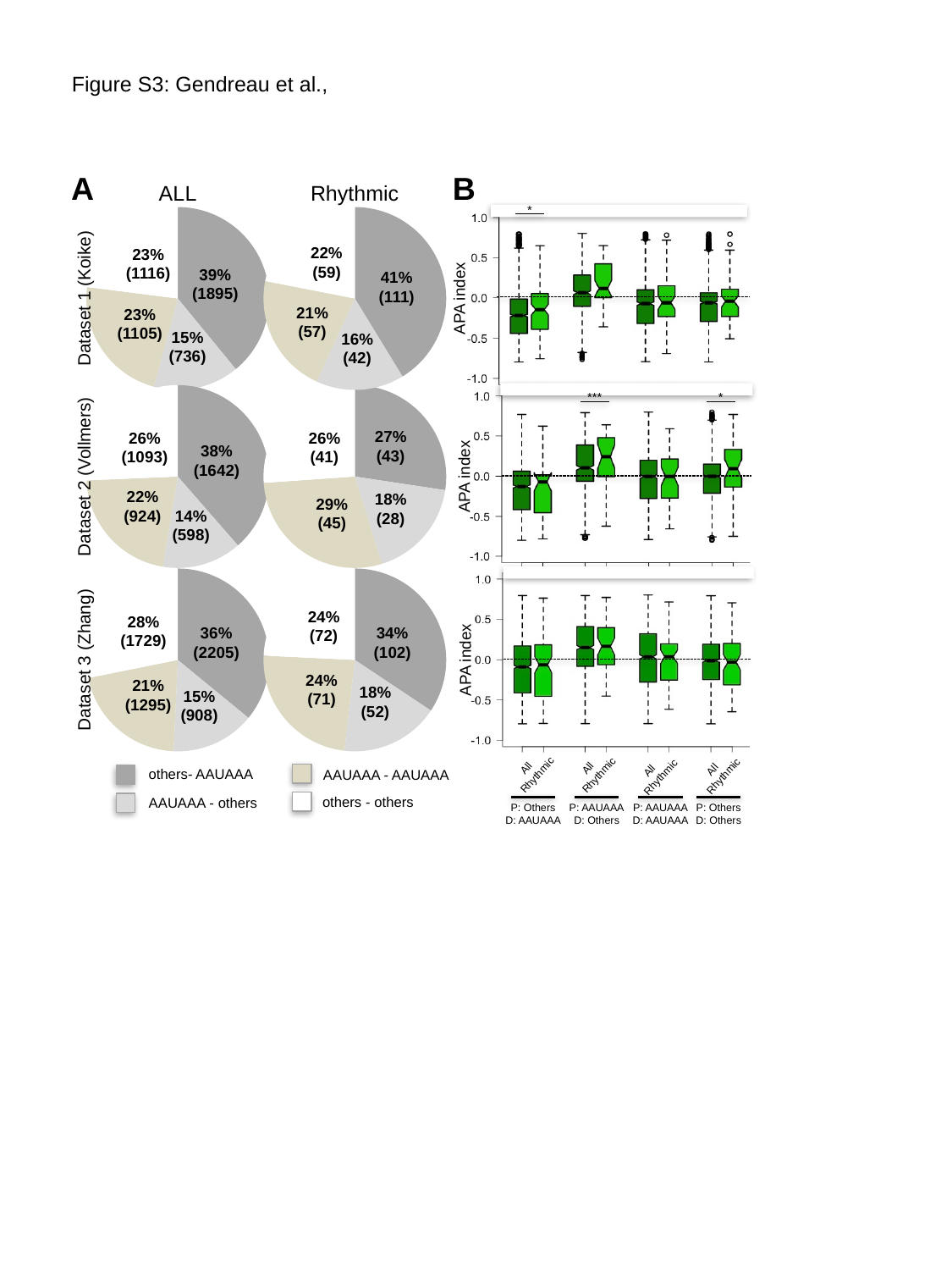
What type of chart is used in panel B? Box plot How many slices does each pie chart in panel A have? 4 In the Dataset 2 (Vollmers) ALL pie chart, which slice has the smallest percentage? AAUAAA - others (14%) In the Dataset 1 (Koike) Rhythmic pie chart, what count is shown in parentheses for the 41% slice? 111 How many pie charts are shown in panel A? 6 In the Dataset 1 (Koike) ALL pie chart, which is larger: the 39% (1895) slice or the 15% (736) slice? 39% (1895) What is the y-axis label of the charts in panel B? APA index In the Dataset 3 (Zhang) Rhythmic pie chart, what is the difference in percentage points between the 34% slice and the 18% slice? 16 In the Dataset 2 (Vollmers) Rhythmic pie chart, which slice has the largest percentage? AAUAAA - AAUAAA (29%) In the Dataset 1 (Koike) ALL pie chart, what percentage is shown for the others- AAUAAA slice? 39% In the Dataset 3 (Zhang) ALL pie chart, what is the count shown for the 36% slice? 2205 How many legend entries are listed below the pie charts in panel A? 4